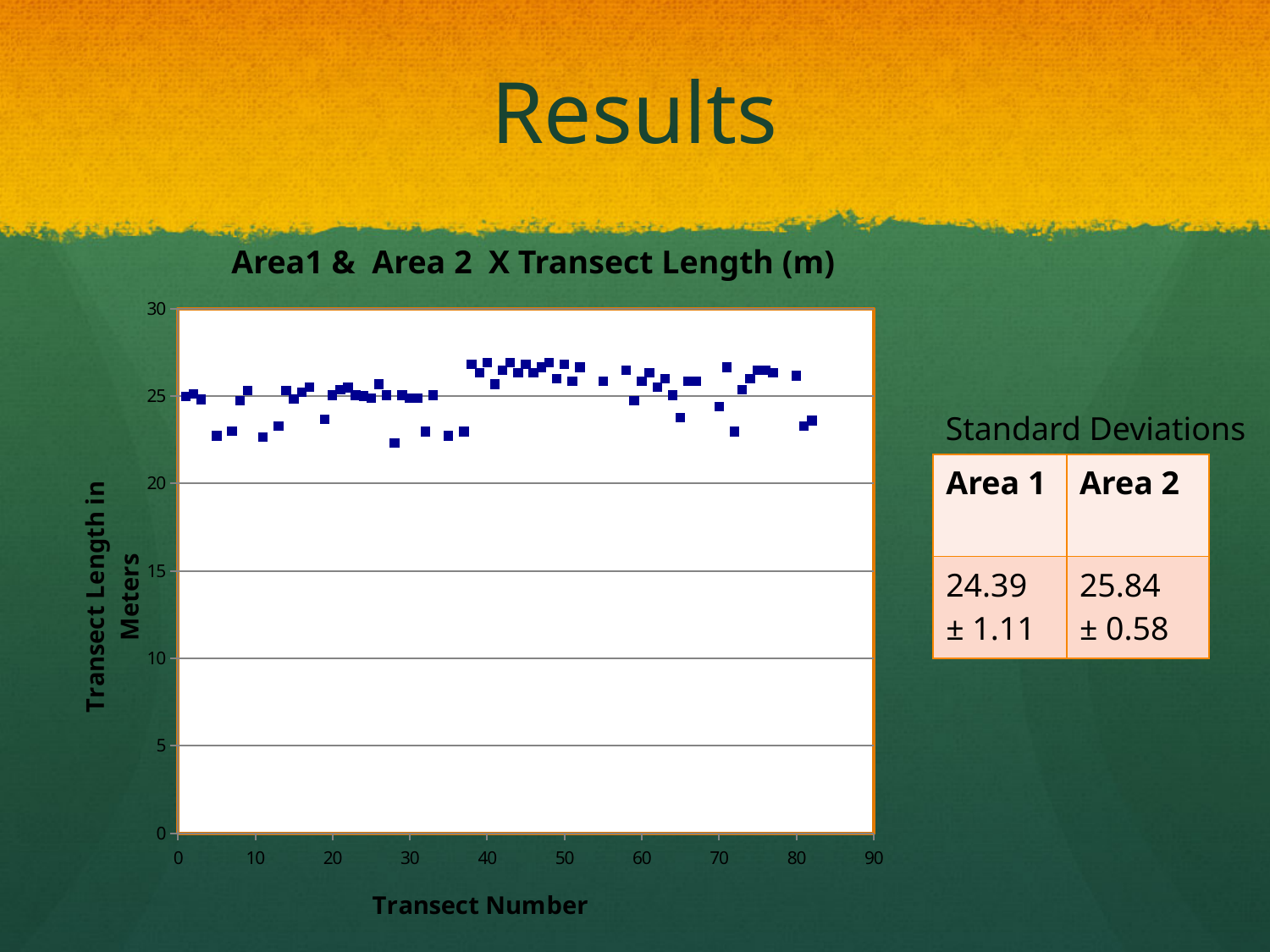
What kind of chart is shown on the slide? scatter chart Is the transect length for transect number 1 greater or less than 20? greater What is the label on the vertical axis of the chart? Transect Length in Meters Are the plotted transect lengths greater or less than 20 meters? greater What is the title of the chart? Area1 & Area 2 X Transect Length (m) Is the transect length plotted at transect number 80 greater or less than 15? greater Are the points plotted around transect numbers 40 to 50 higher or lower than the points around transect numbers 0 to 10? higher